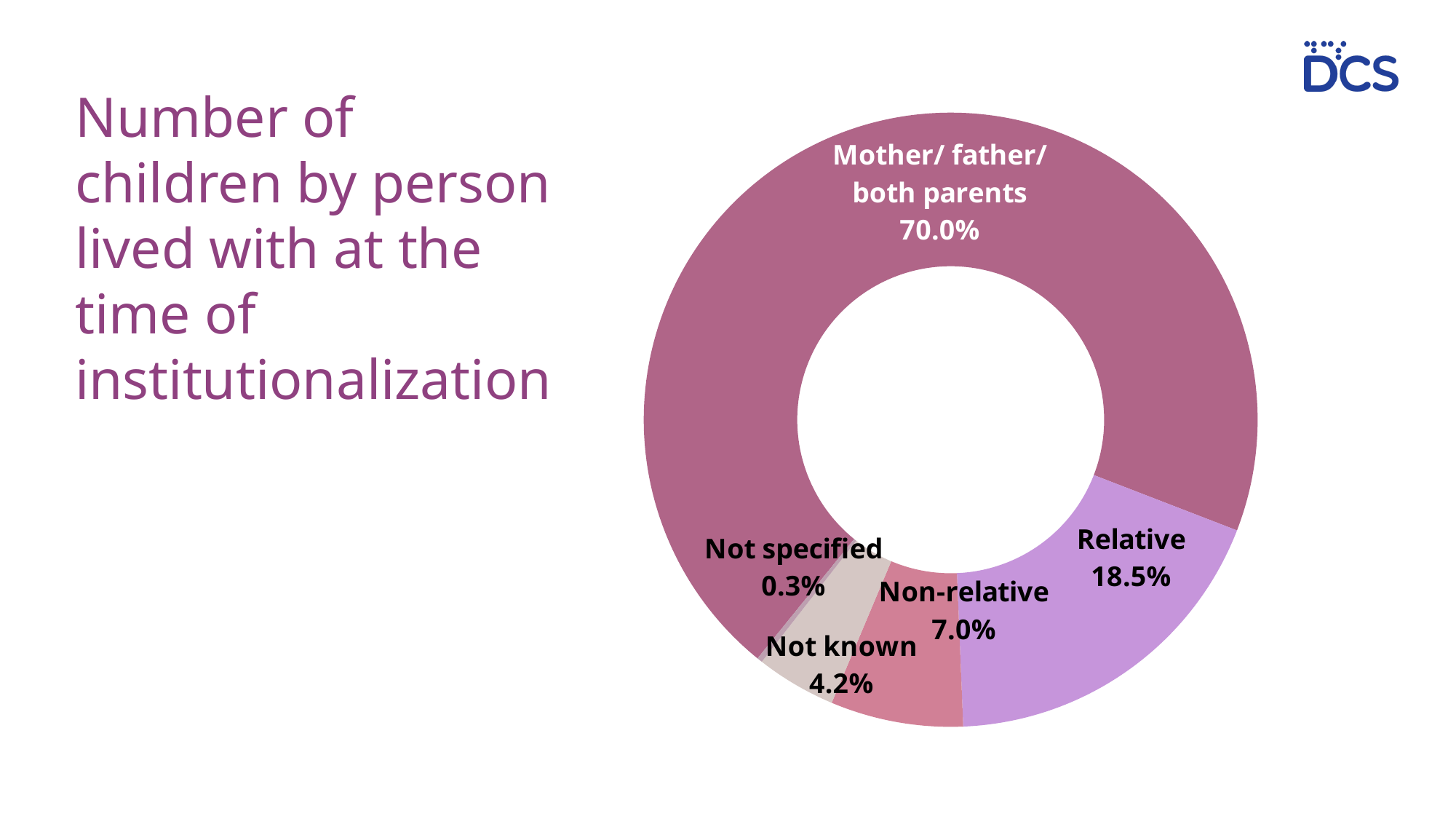
What share of children lived with mother/ father/ both parents at the time of institutionalization? 70.0% How many categories are shown in the chart? 5 Which category has the largest share of the chart? Mother/ father/ both parents What is the value shown for Non-relative? 7.0% What percentage of children lived with a relative? 18.5% Which category has the smallest share of the chart? Not specified Which is larger, the share for Not known or the share for Non-relative? Non-relative What is the value for Not specified? 0.3% What percentage is shown for Not known? 4.2% What is the difference in percentage points between Relative and Non-relative? 11.5 What is the title of the slide? Number of children by person lived with at the time of institutionalization What kind of chart is shown on the slide? Pie chart (doughnut)